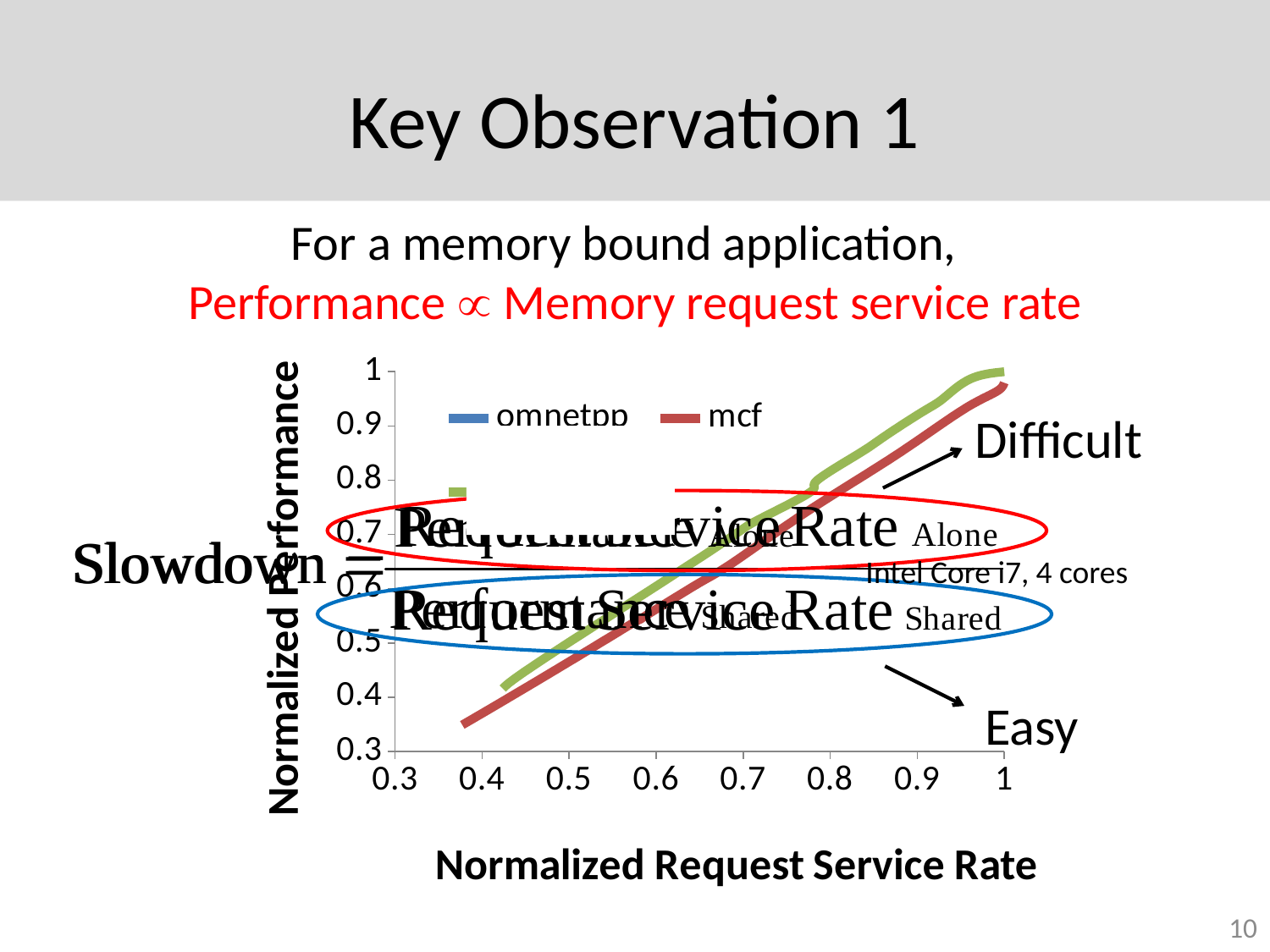
Do the plotted lines rise or fall as the normalized request service rate increases? rise Is the value of the mcf line at a normalized request service rate of 1 greater or less than 0.9? greater Is the value of the mcf line at a normalized request service rate of 0.7 greater or less than 0.5? greater What is the lowest value shown on the y axis of the chart? 0.3 What kind of chart is shown on the slide? line chart What is the title of the x axis of the chart? Normalized Request Service Rate